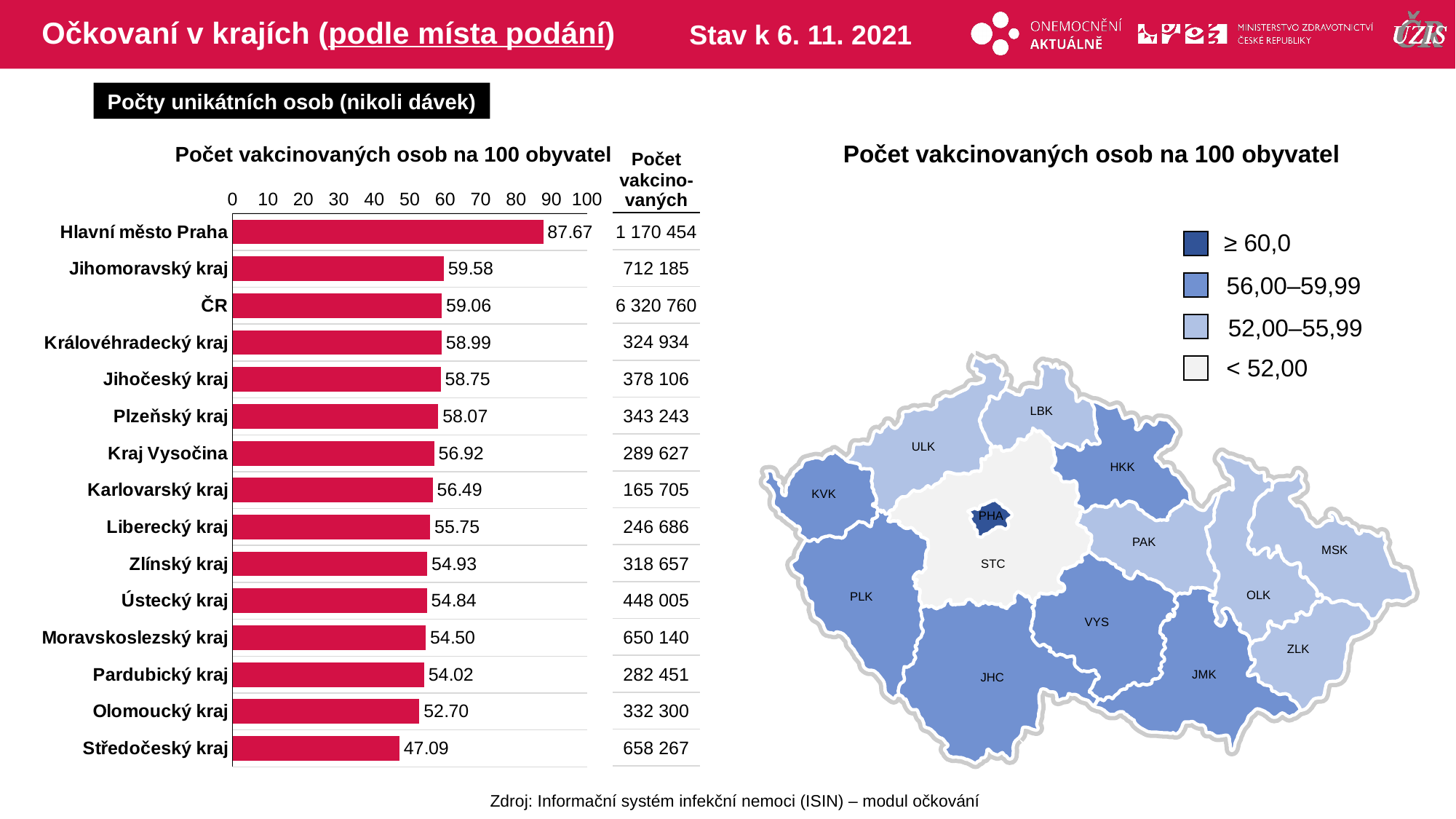
Is the value for Kraj Vysočina in the bar chart greater or less than 60? less In the bar chart, what is the value for Středočeský kraj? 47.09 Which region has the highest number of vaccinated persons per 100 inhabitants in the bar chart? Hlavní město Praha In the bar chart, what is the value for Hlavní město Praha? 87.67 How many bars (categories) are shown in the bar chart? 15 What type of chart is used to show the number of vaccinated persons per 100 inhabitants by region? Bar chart What is the difference between the values for Hlavní město Praha and Středočeský kraj in the bar chart? 40.58 In the bar chart, which has a larger value: Jihomoravský kraj or Olomoucký kraj? Jihomoravský kraj In the bar chart, what is the value for ČR? 59.06 What is the difference between the values for Zlínský kraj and Ústecký kraj in the bar chart? 0.09 What is the title of the bar chart on the left? Počet vakcinovaných osob na 100 obyvatel Which region has the lowest number of vaccinated persons per 100 inhabitants in the bar chart? Středočeský kraj